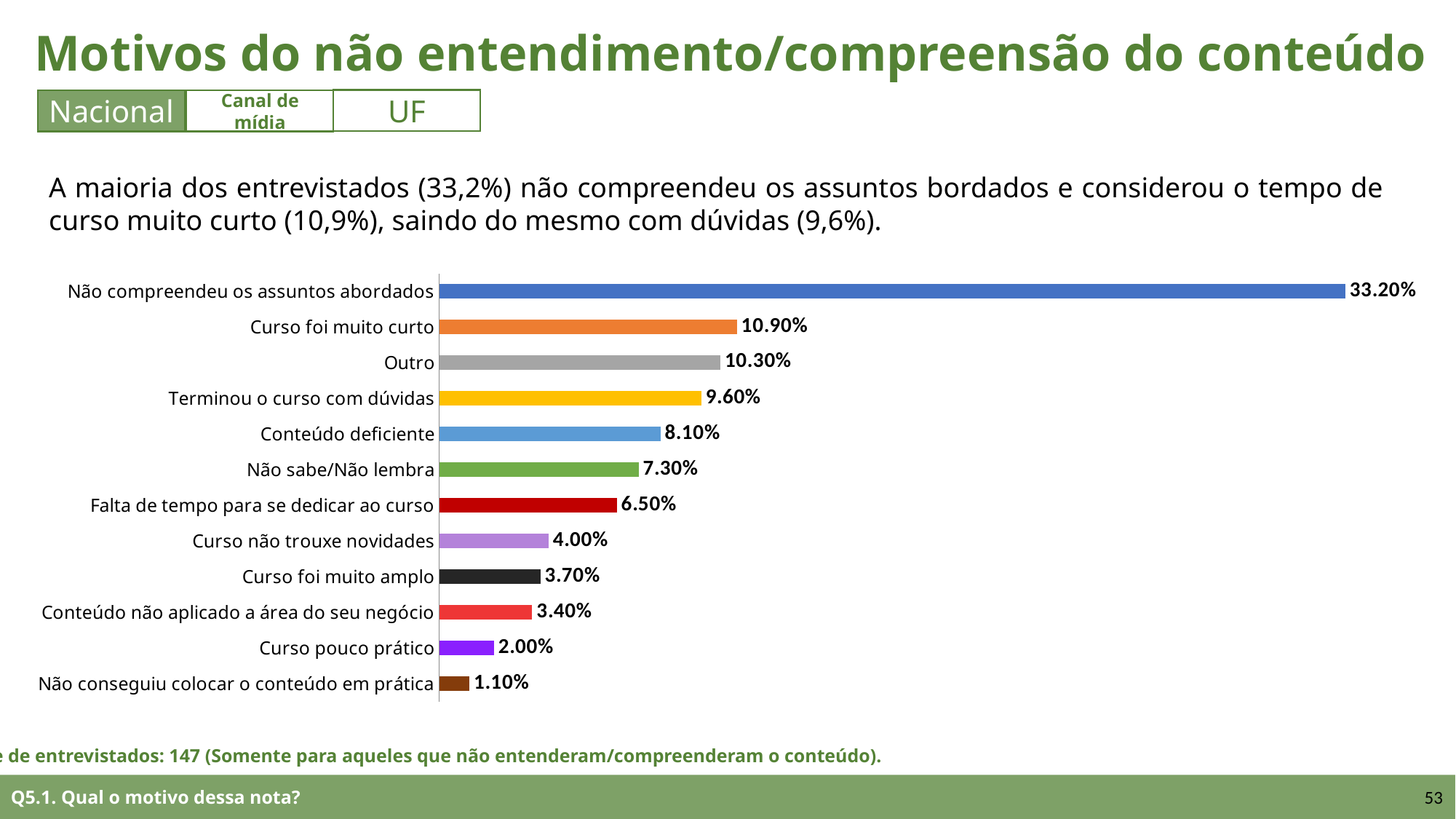
Which is larger, "Conteúdo deficiente" or "Não sabe/Não lembra"? Conteúdo deficiente What is the value for "Terminou o curso com dúvidas"? 9.60% What is the difference between "Não compreendeu os assuntos abordados" and "Curso foi muito curto"? 22.30% What colour is the bar for "Falta de tempo para se dedicar ao curso"? Dark red What is the value for "Curso pouco prático"? 2.00% What kind of chart is shown on the slide? Bar chart How many categories are shown in the chart? 12 What is the value for "Não compreendeu os assuntos abordados"? 33.20% What is the difference between "Curso foi muito curto" and "Outro"? 0.60% Which category has the highest value? Não compreendeu os assuntos abordados Which category has the lowest value? Não conseguiu colocar o conteúdo em prática Which is larger, "Curso foi muito amplo" or "Curso não trouxe novidades"? Curso não trouxe novidades